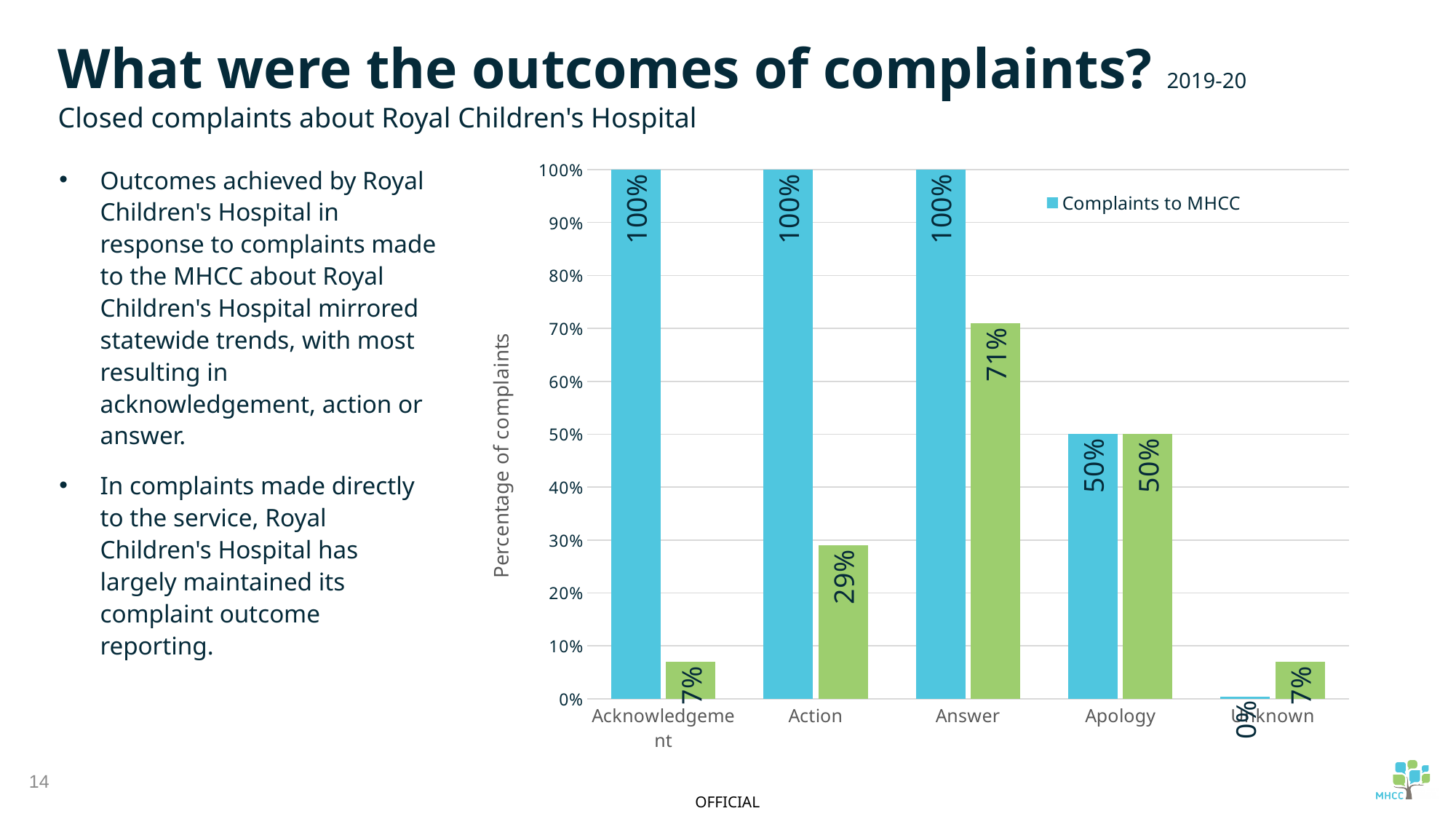
How many categories are shown on the x axis? 5 Which category has the lowest Complaints to MHCC value? Unknown What is the value of the green bar for Action? 29% What is the Complaints to MHCC value for Apology? 50% What is the value of the green bar for Answer? 71% How many series does the legend list? 1 What is the difference between the Complaints to MHCC value and the green bar value for Answer? 29 percentage points What is the difference between the Complaints to MHCC value and the green bar value for Action? 71 percentage points What is the Complaints to MHCC value for Unknown? 0% What kind of chart is shown on the slide? Bar chart For Acknowledgement, which is larger: the Complaints to MHCC bar or the green bar? Complaints to MHCC Which category has the highest green bar? Answer